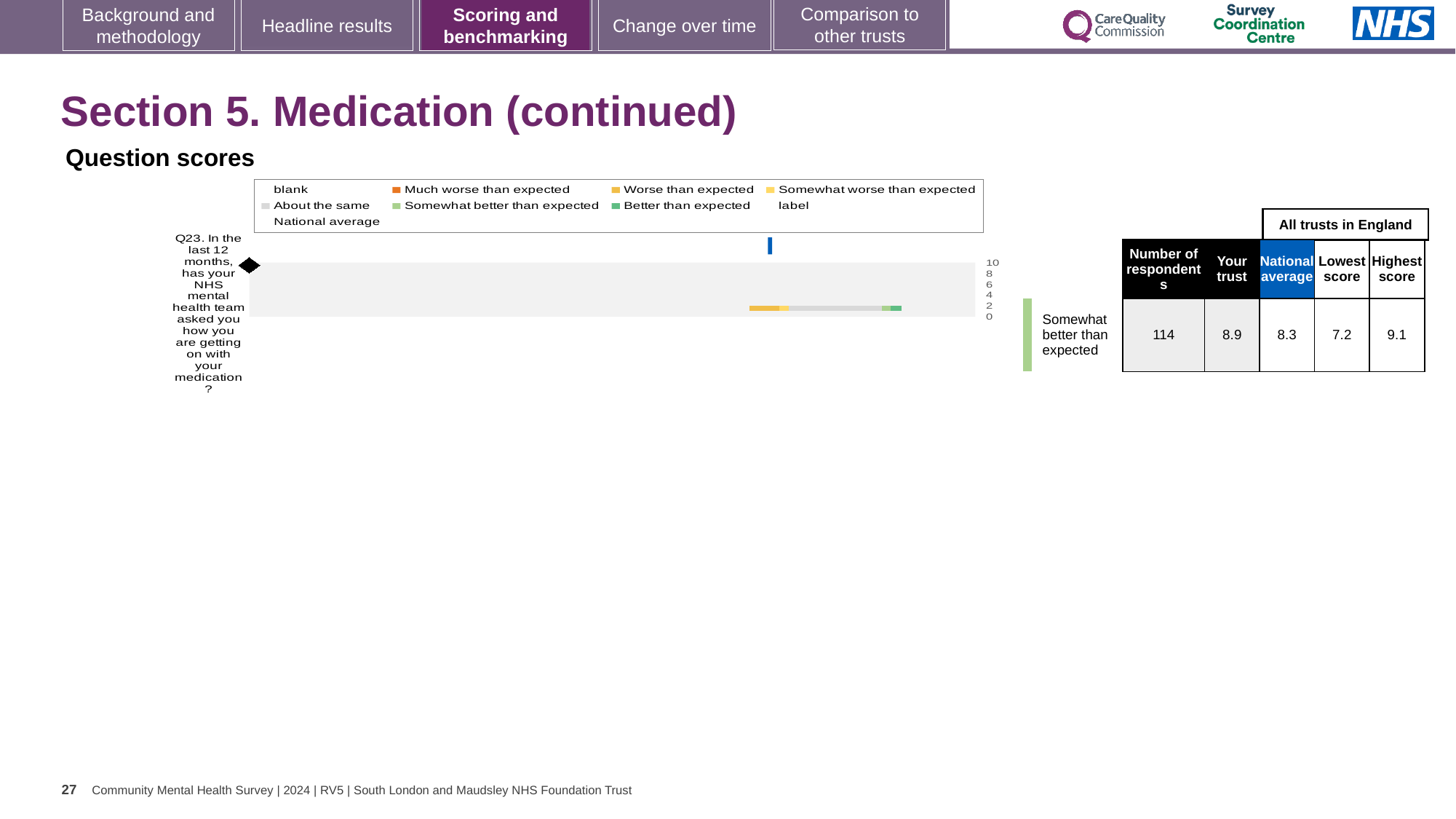
What is the highest value shown on the chart's score axis? 10 How many questions (categories) are plotted on the chart? 1 What is the highest score among all trusts in England for Q23? 9.1 What is the difference between the trust's score and the national average for Q23? 0.6 What is the lowest score among all trusts in England for Q23? 7.2 What is the difference between the highest and lowest scores among all trusts for Q23? 1.9 What kind of chart is used to show the Q23 question score? bar chart Which is higher for Q23: the trust's score or the national average? Your trust How many respondents answered Q23? 114 Which benchmarking band does the trust's Q23 score fall into? Somewhat better than expected What is the national average score for Q23? 8.3 What is the 'Your trust' score for Q23 shown alongside the chart? 8.9